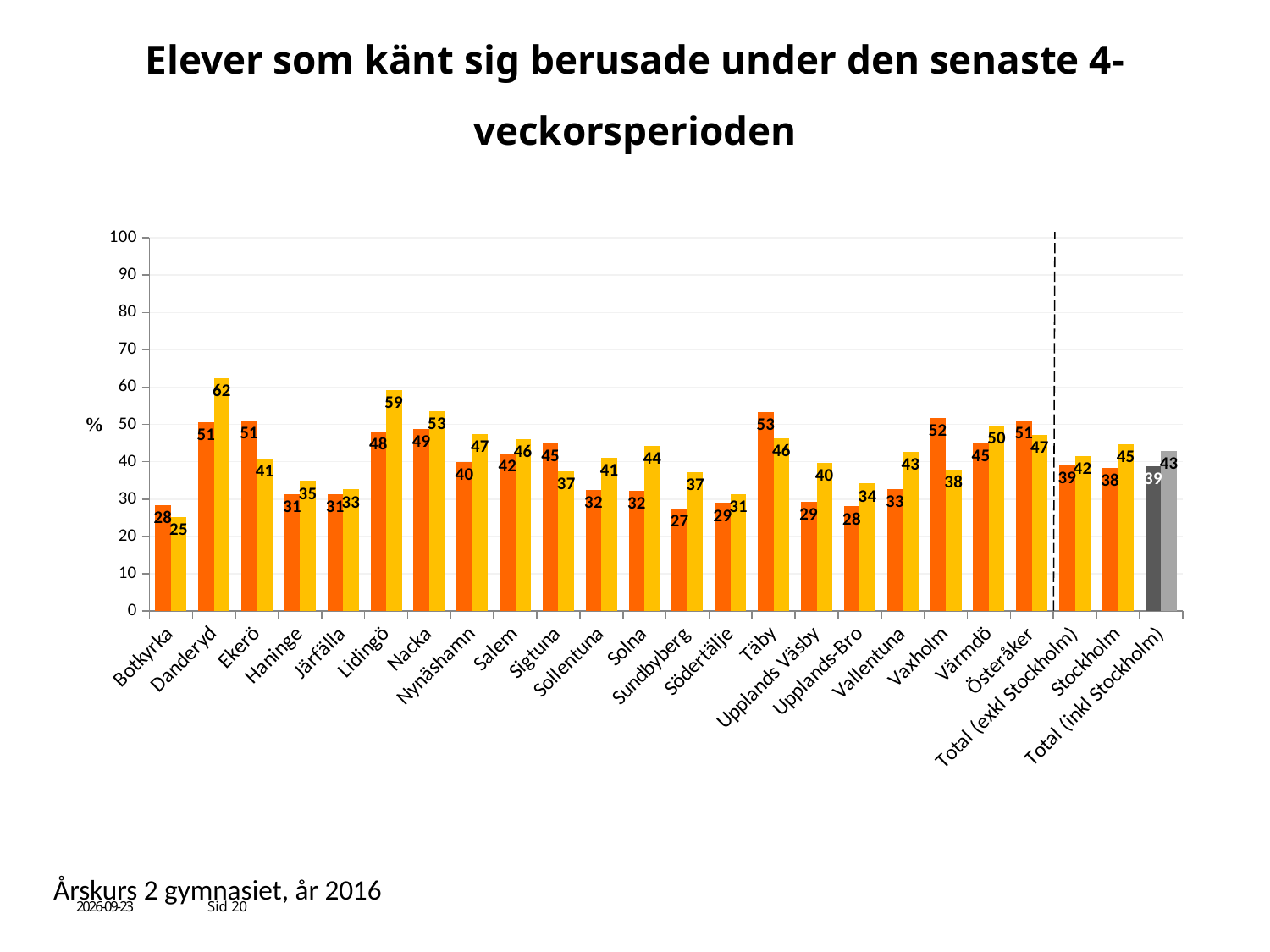
What is the difference between the orange bar for Vaxholm and the yellow bar for Vaxholm? 14 Which is larger for Sigtuna, the orange bar or the yellow bar? the orange bar What is the value of the yellow bar for Danderyd? 62 What kind of chart is shown on the slide? bar chart How many categories are shown on the x axis? 24 Which municipality has the lowest orange bar? Sundbyberg What is the difference between the yellow bar and the orange bar for Lidingö? 11 What is the value of the yellow bar for Stockholm? 45 What is the value of the orange bar for Täby? 53 Which municipality has the lowest yellow bar? Botkyrka Which municipality has the highest yellow bar? Danderyd Is the yellow bar for Nacka greater or less than 50? greater